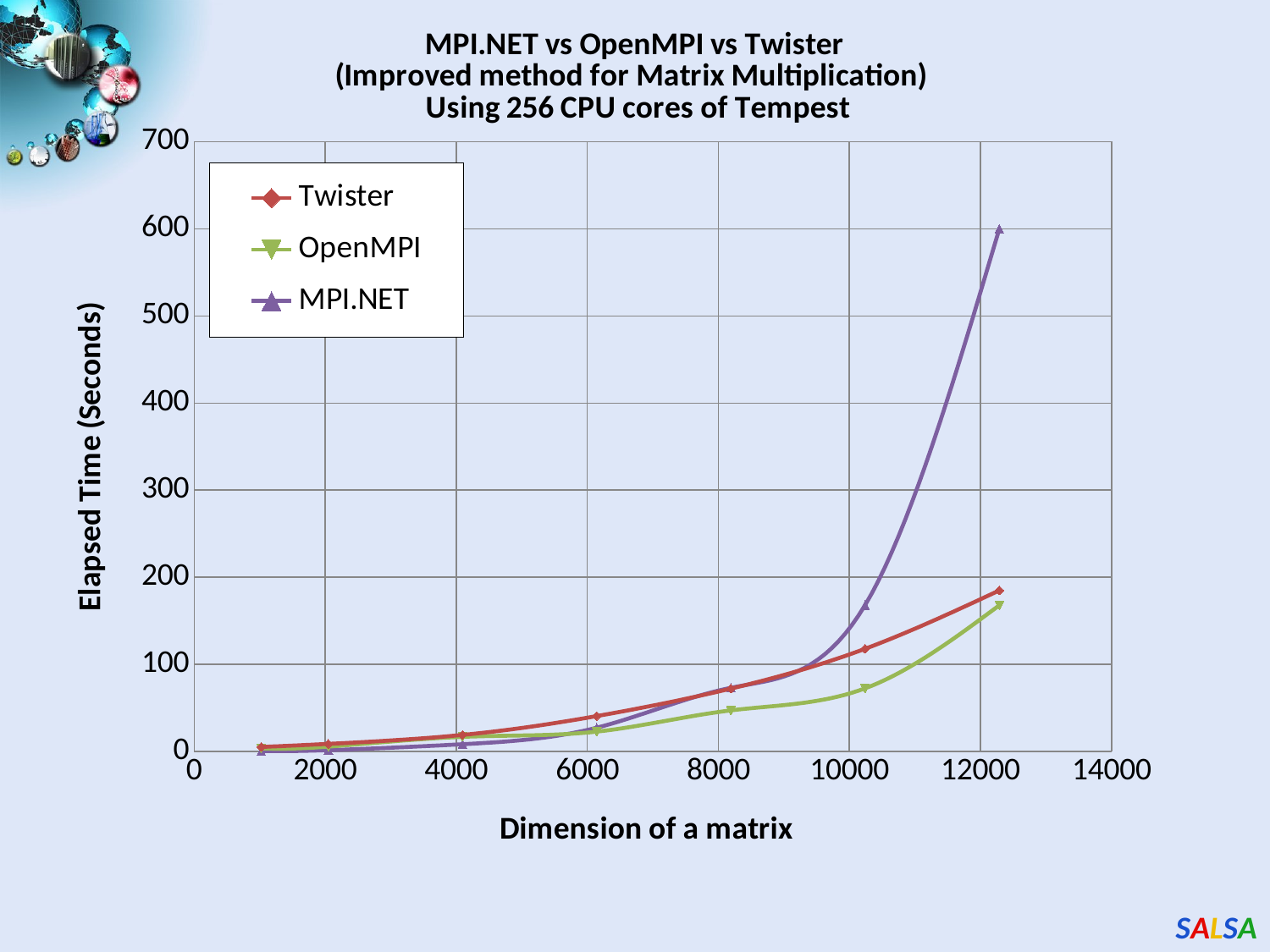
How many series does the legend list? 3 Is the elapsed time for Twister at the largest matrix dimension greater or less than 300 seconds? less Is the elapsed time for MPI.NET at a matrix dimension of about 10000 greater or less than 100 seconds? greater Does the elapsed time for MPI.NET rise or fall as the matrix dimension increases? rise At a matrix dimension of about 10000, which has the larger elapsed time, Twister or OpenMPI? Twister What is the label of the y axis? Elapsed Time (Seconds) How many data points are plotted for the Twister series? 7 What kind of chart is shown on the slide? line chart Is the elapsed time for OpenMPI at a matrix dimension of about 10000 greater or less than 100 seconds? less Which series are listed in the legend? Twister, OpenMPI, MPI.NET Which series has the highest elapsed time at the largest matrix dimension plotted? MPI.NET